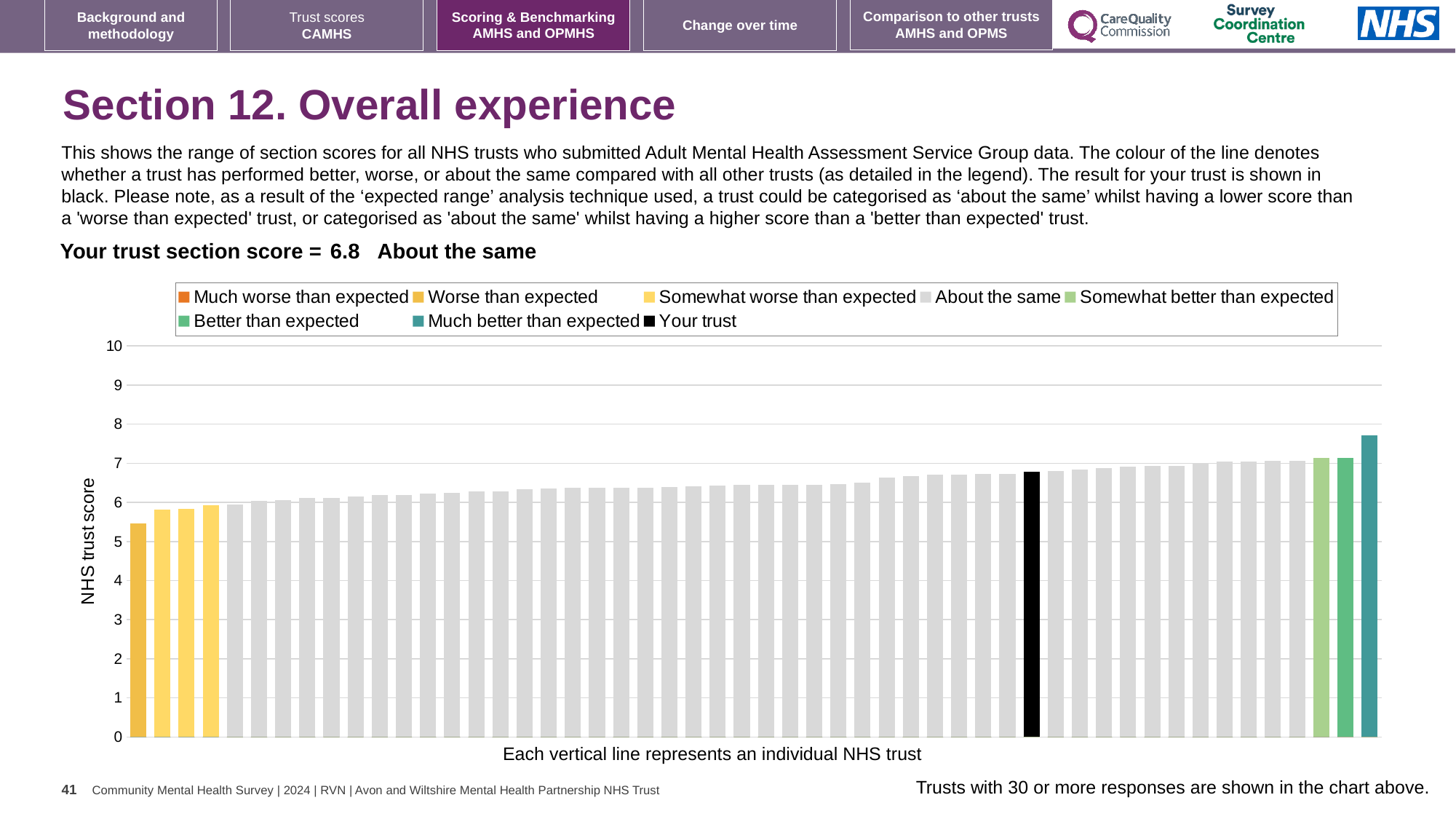
How is your trust categorised compared with other trusts? About the same Do the bar values rise or fall from left to right along the x axis? rise Which is larger: the value for your trust or the value for the far-right 'Much better than expected' bar? the far-right 'Much better than expected' bar Is the value for the lowest bar on the far left greater or less than 5? greater Is the value for the black 'Your trust' bar greater or less than 6? greater How many entries does the chart legend list? 8 How many bars are shown in the 'Much better than expected' colour? 1 Is the value for the lowest bar on the far left greater or less than 6? less What is the section score for your trust shown on the slide? 6.8 What is the label on the vertical axis of the chart? NHS trust score What kind of chart is shown on the slide? bar chart